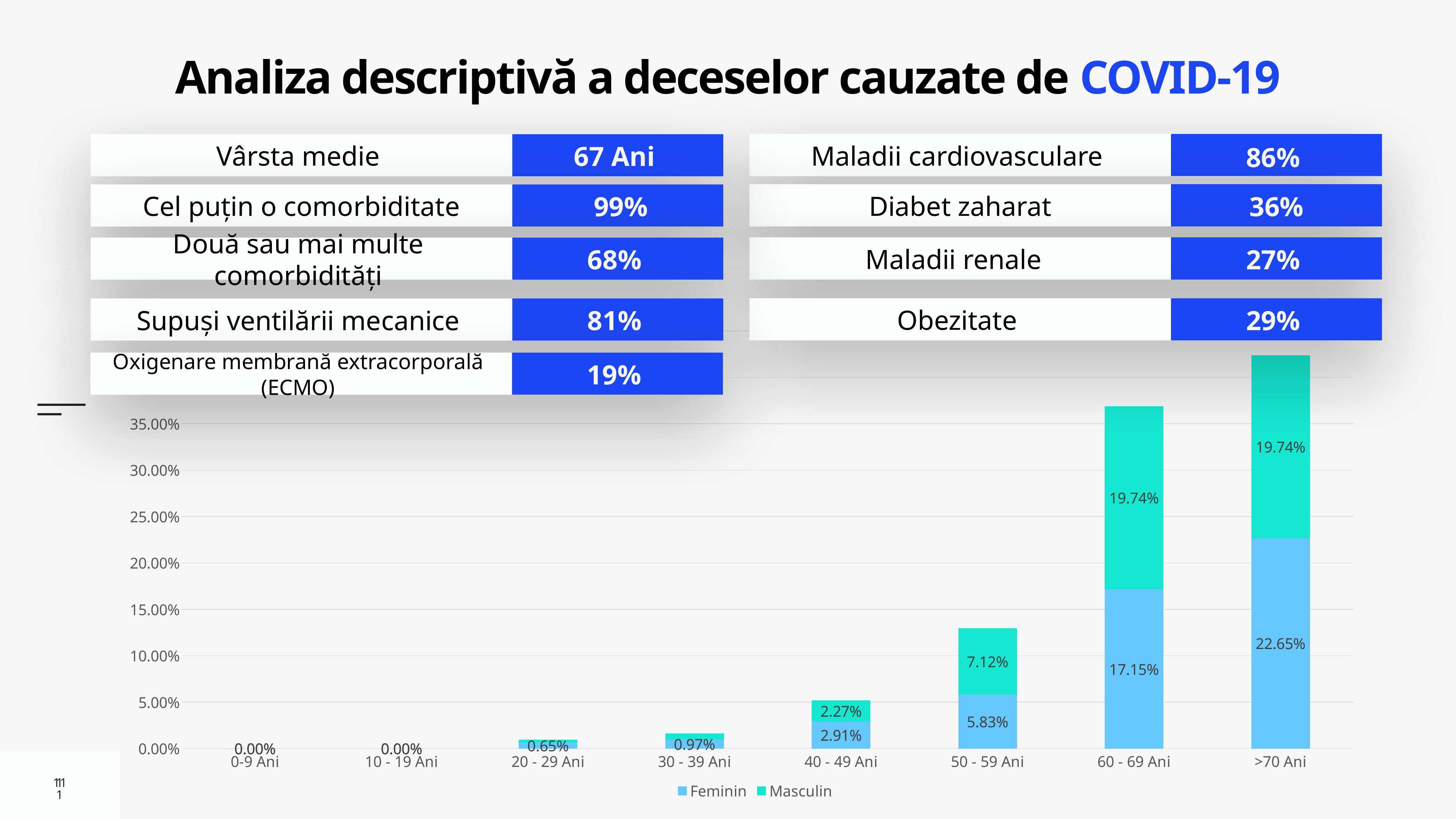
What is the Masculin value for the 50 - 59 Ani age group? 7.12% What is the Feminin value for the 60 - 69 Ani age group? 17.15% Which age group has the highest Feminin value? >70 Ani What kind of chart is shown on the slide? stacked bar chart Is the total stacked value for the 60 - 69 Ani age group greater or less than 35.00%? greater What is the difference between the Feminin and Masculin values for the 40 - 49 Ani age group? 0.64% What is the total stacked value for the 50 - 59 Ani age group? 12.95% What is the Feminin value for the >70 Ani age group? 22.65% How many series does the chart legend list? 2 For the 50 - 59 Ani age group, which is larger, the Feminin or the Masculin value? Masculin How many age groups are shown on the x axis of the chart? 8 Do the Feminin values rise or fall from 40 - 49 Ani to >70 Ani? rise